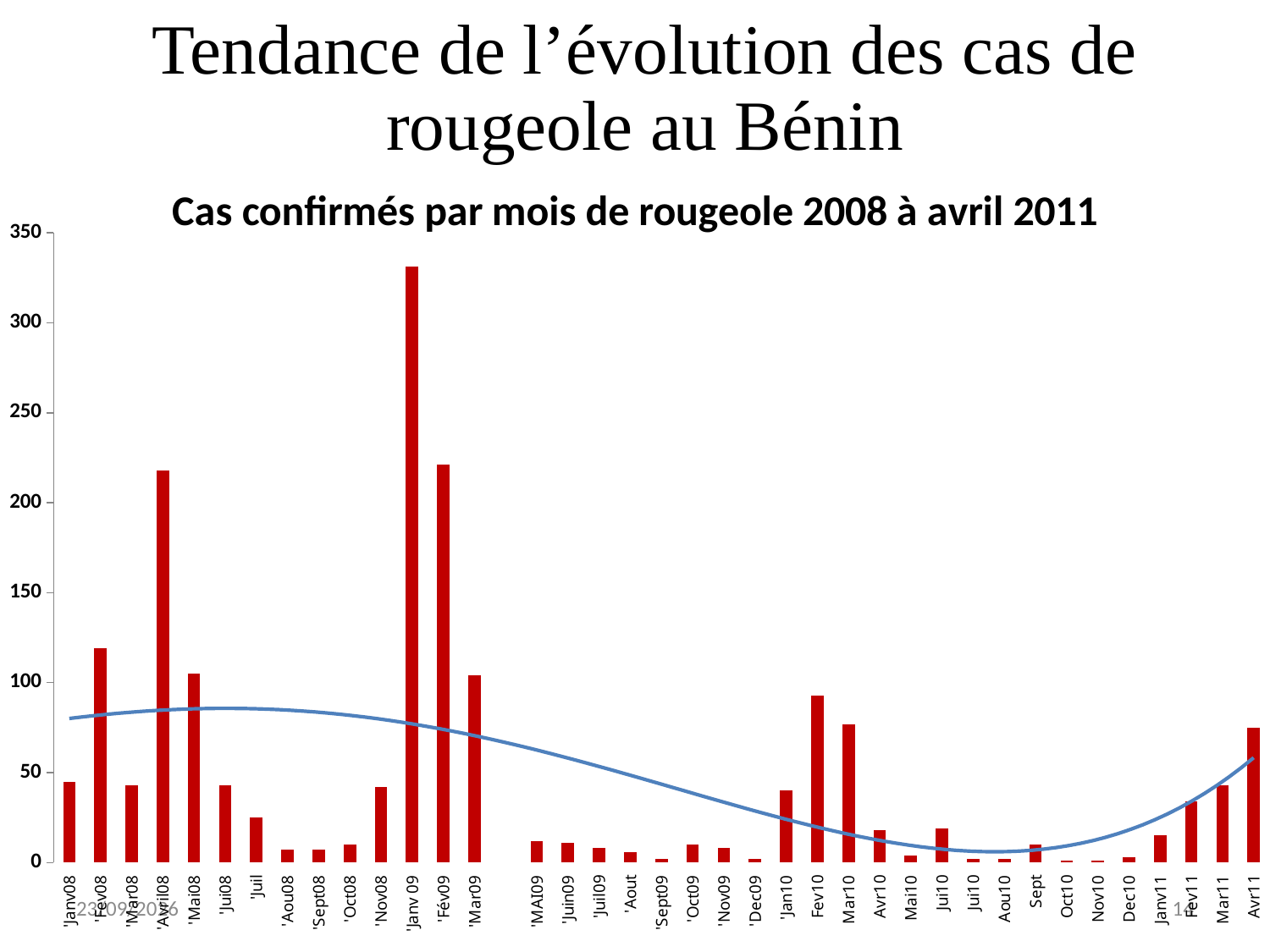
What is the title of the chart? Cas confirmés par mois de rougeole 2008 à avril 2011 Which is larger, the value for Fev10 or the value for Mar10? Fev10 Is the value for Janv 09 greater or less than 300? greater What colour are the bars in the chart? red What kind of chart is shown on the slide? bar chart Which is larger, the value for Avril08 or the value for Mai08? Avril08 Is the value for Fév08 greater or less than 100? greater Is the value for Fev10 greater or less than 100? less Which month has the highest number of confirmed measles cases? Janv 09 Does the blue trend line rise or fall between Mar09 and Aou10? fall